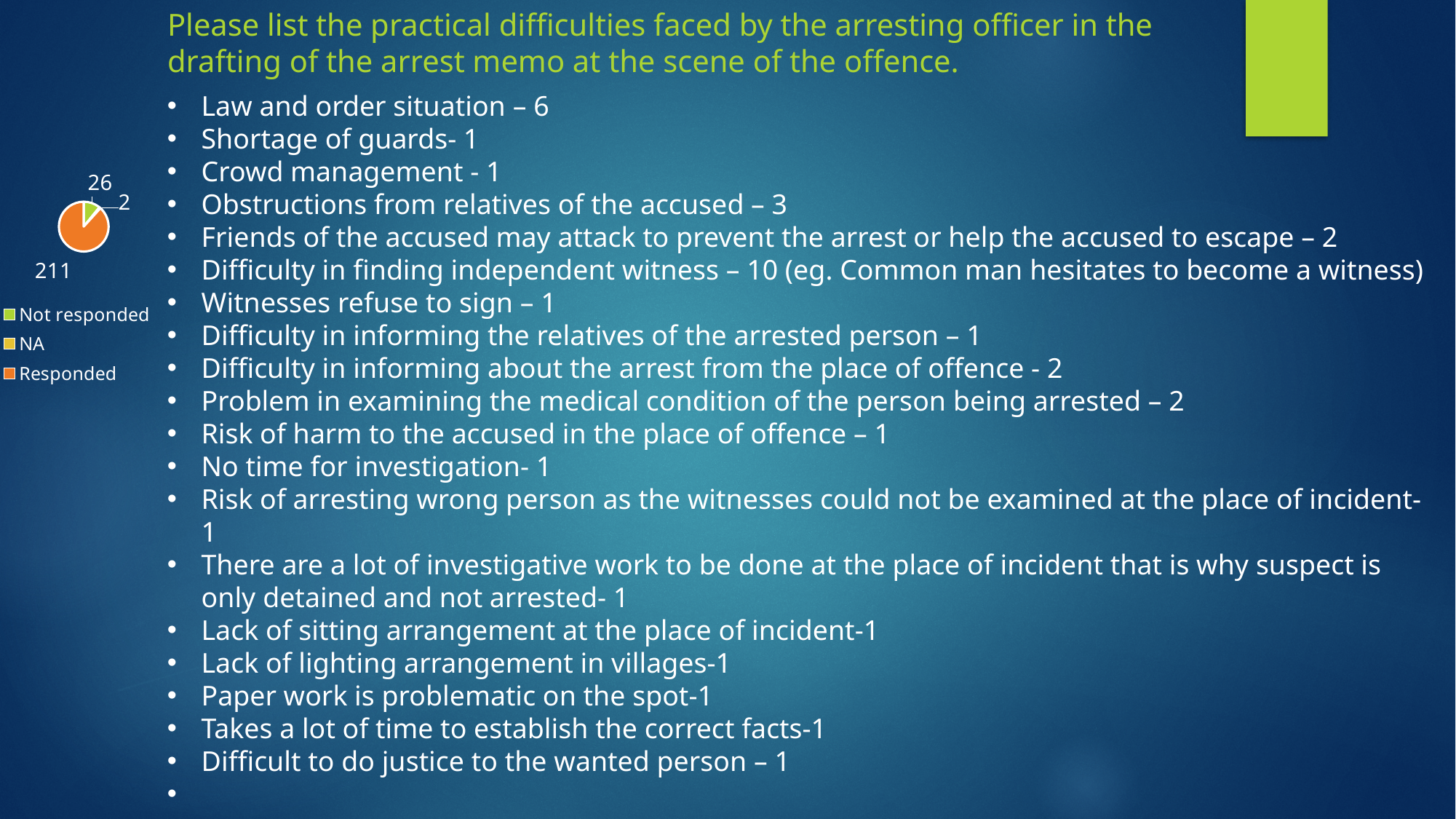
Which category has the smallest slice in the pie chart? NA How many slices does the pie chart have? 3 In the pie chart, what is the value for NA? 2 What is the total of all the values shown in the pie chart? 239 In the pie chart, what is the difference between the Responded and Not responded values? 185 In the pie chart, what is the value for Responded? 211 What kind of chart is shown on the left of the slide? pie chart In the pie chart, what is the difference between the Not responded and NA values? 24 How many entries does the pie chart's legend list? 3 Which category has the largest slice in the pie chart? Responded In the pie chart, which is larger: Not responded or NA? Not responded In the pie chart, what is the value for Not responded? 26